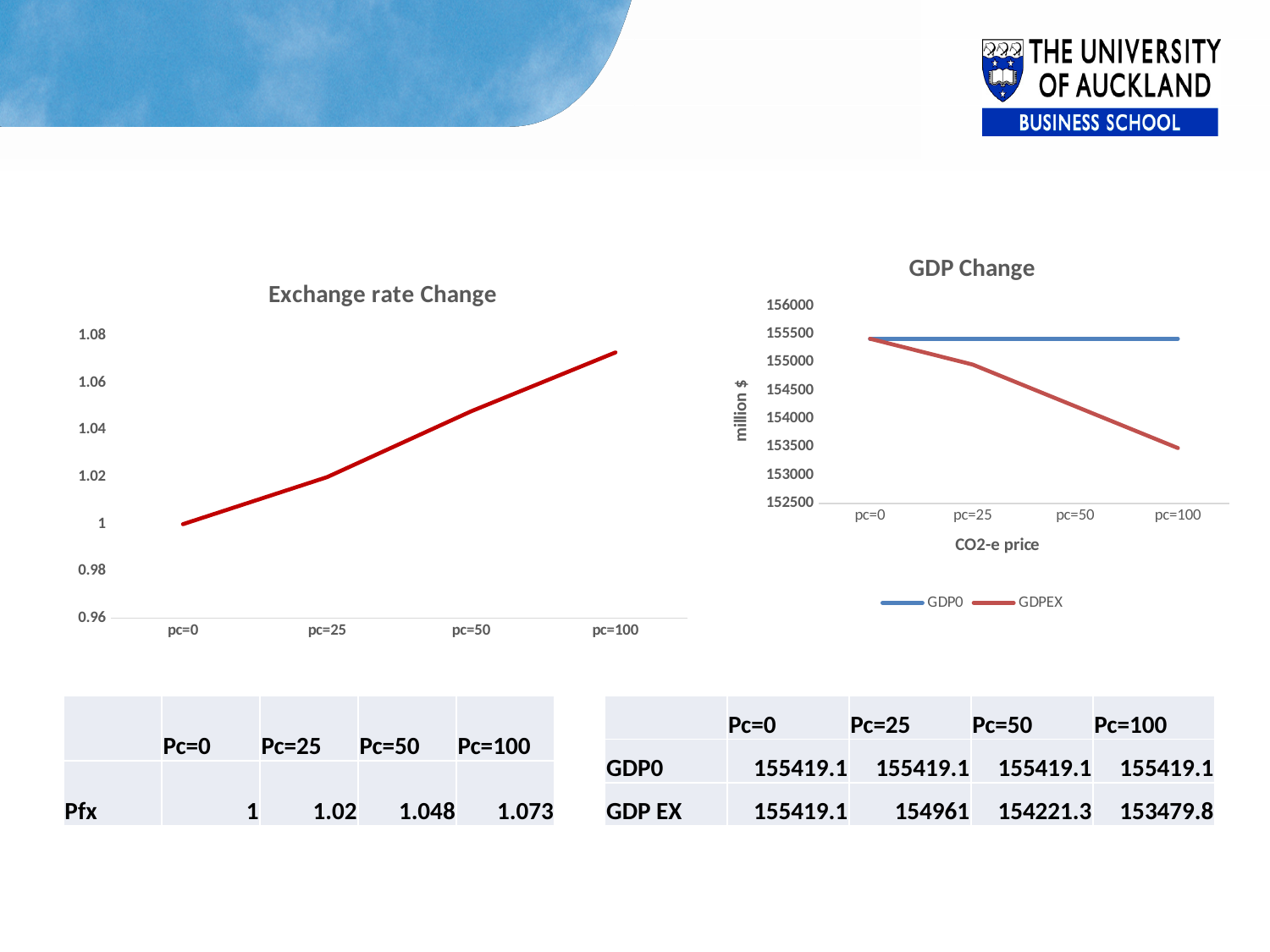
In the "GDP Change" chart, how many series does the legend list? 2 In the "Exchange rate Change" chart, how many points are plotted along the x axis? 4 In the "Exchange rate Change" chart, is the value at pc=100 greater or less than 1.06? greater In the "Exchange rate Change" chart, do the values rise or fall as the CO2 price increases from pc=0 to pc=100? rise In the "Exchange rate Change" chart, what is the value of Pfx at pc=100? 1.073 In the "GDP Change" chart, is the GDPEX value at pc=100 greater or less than 154000? less In the "GDP Change" chart, which series is higher at pc=100, GDP0 or GDPEX? GDP0 What kind of chart is the "Exchange rate Change" chart? line chart In the "GDP Change" chart, what is the label of the x axis? CO2-e price In the "GDP Change" chart, what is the value of GDP0 at pc=25? 155419.1 In the "Exchange rate Change" chart, what is the value of Pfx at pc=50? 1.048 In the "GDP Change" chart, what is the value of GDP EX at pc=100? 153479.8